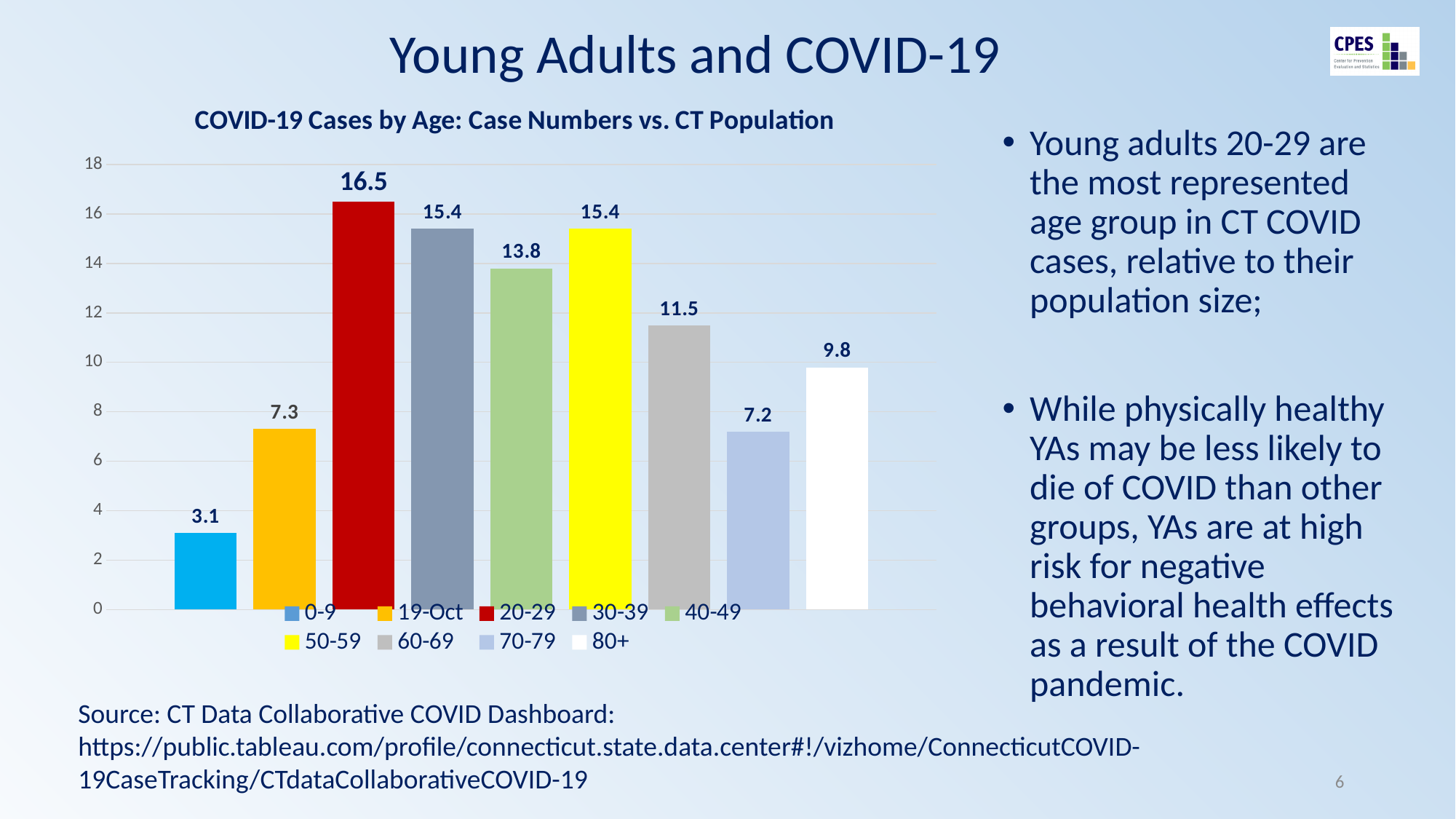
What is the difference between the values for the 20-29 and 0-9 age groups? 13.4 Is the value for the 40-49 age group greater or less than 12? greater What is the title of the chart? COVID-19 Cases by Age: Case Numbers vs. CT Population Which age group has the highest bar in the chart? 20-29 What is the value shown for the 0-9 age group? 3.1 Which age group has the lowest bar in the chart? 0-9 What kind of chart is shown on the slide? Bar chart Which has a larger value, the 60-69 age group or the 80+ age group? 60-69 What is the value shown for the 80+ age group? 9.8 What is the value shown for the 20-29 age group? 16.5 What is the difference between the values for the 30-39 and 40-49 age groups? 1.6 How many age-group bars are plotted in the chart? 9